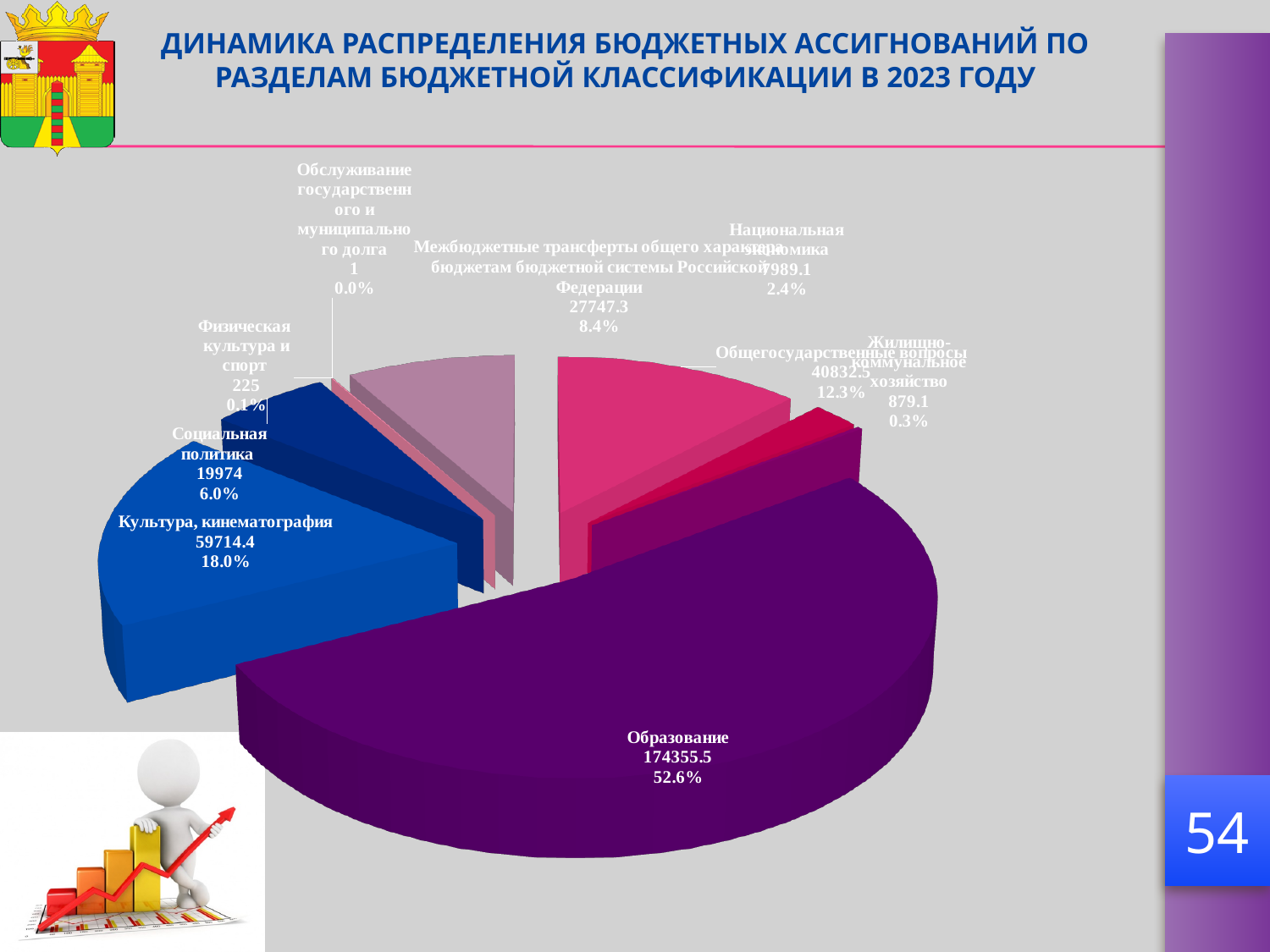
Which category has the smallest value? Обслуживание государственного и муниципального долга What is the value for Национальная экономика? 7989.1 What share of the pie does Образование take? 52.6% Which category has the largest value? Образование What kind of chart is shown on the slide? pie chart Which is larger: the value for Общегосударственные вопросы or the value for Межбюджетные трансферты общего характера бюджетам бюджетной системы Российской Федерации? Общегосударственные вопросы What share of the pie does Социальная политика take? 6.0% What is the value for Культура, кинематография? 59714.4 What is the value for Общегосударственные вопросы? 40832.5 How many categories are shown in the pie chart? 9 What is the difference between the values for Культура, кинематография and Социальная политика? 39740.4 What is the value for Образование? 174355.5